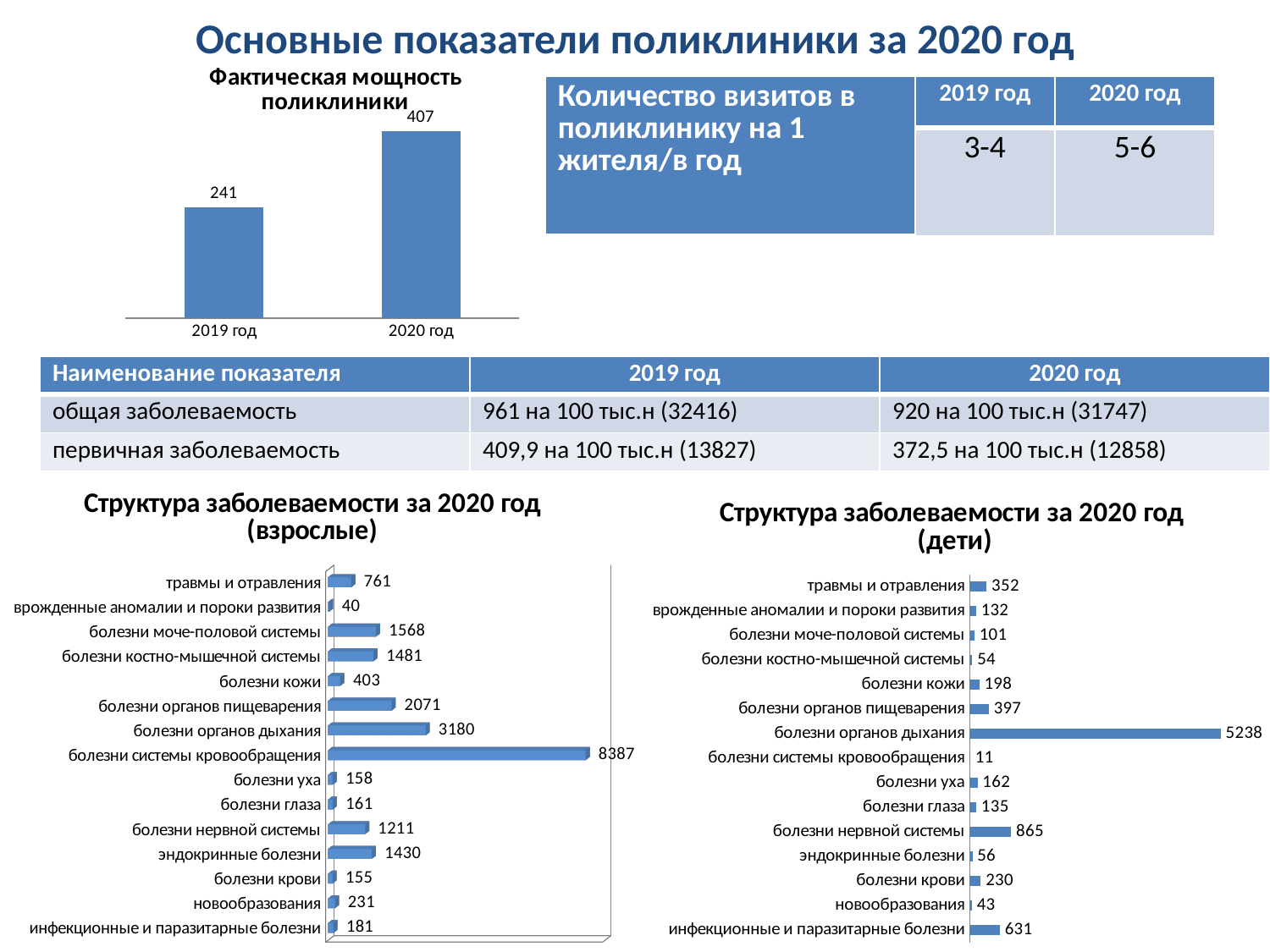
In the chart 'Структура заболеваемости за 2020 год (дети)', what is the difference between травмы и отравления and болезни кожи? 154 In the chart 'Структура заболеваемости за 2020 год (дети)', which category has the highest value? болезни органов дыхания In the chart 'Структура заболеваемости за 2020 год (дети)', what is the value for болезни нервной системы? 865 In the chart 'Структура заболеваемости за 2020 год (взрослые)', what is the value for болезни органов дыхания? 3180 In the chart 'Структура заболеваемости за 2020 год (взрослые)', which category has the lowest value? врожденные аномалии и пороки развития In the chart 'Структура заболеваемости за 2020 год (взрослые)', how many categories are shown? 15 In the chart 'Структура заболеваемости за 2020 год (взрослые)', which is larger: болезни моче-половой системы or болезни костно-мышечной системы? болезни моче-половой системы In the chart 'Структура заболеваемости за 2020 год (дети)', which category has the lowest value? болезни системы кровообращения In the chart 'Фактическая мощность поликлиники', what is the value for 2020 год? 407 What kind of chart is 'Фактическая мощность поликлиники'? bar chart In the chart 'Фактическая мощность поликлиники', what is the difference between the values for 2020 год and 2019 год? 166 In the chart 'Структура заболеваемости за 2020 год (взрослые)', which category has the highest value? болезни системы кровообращения